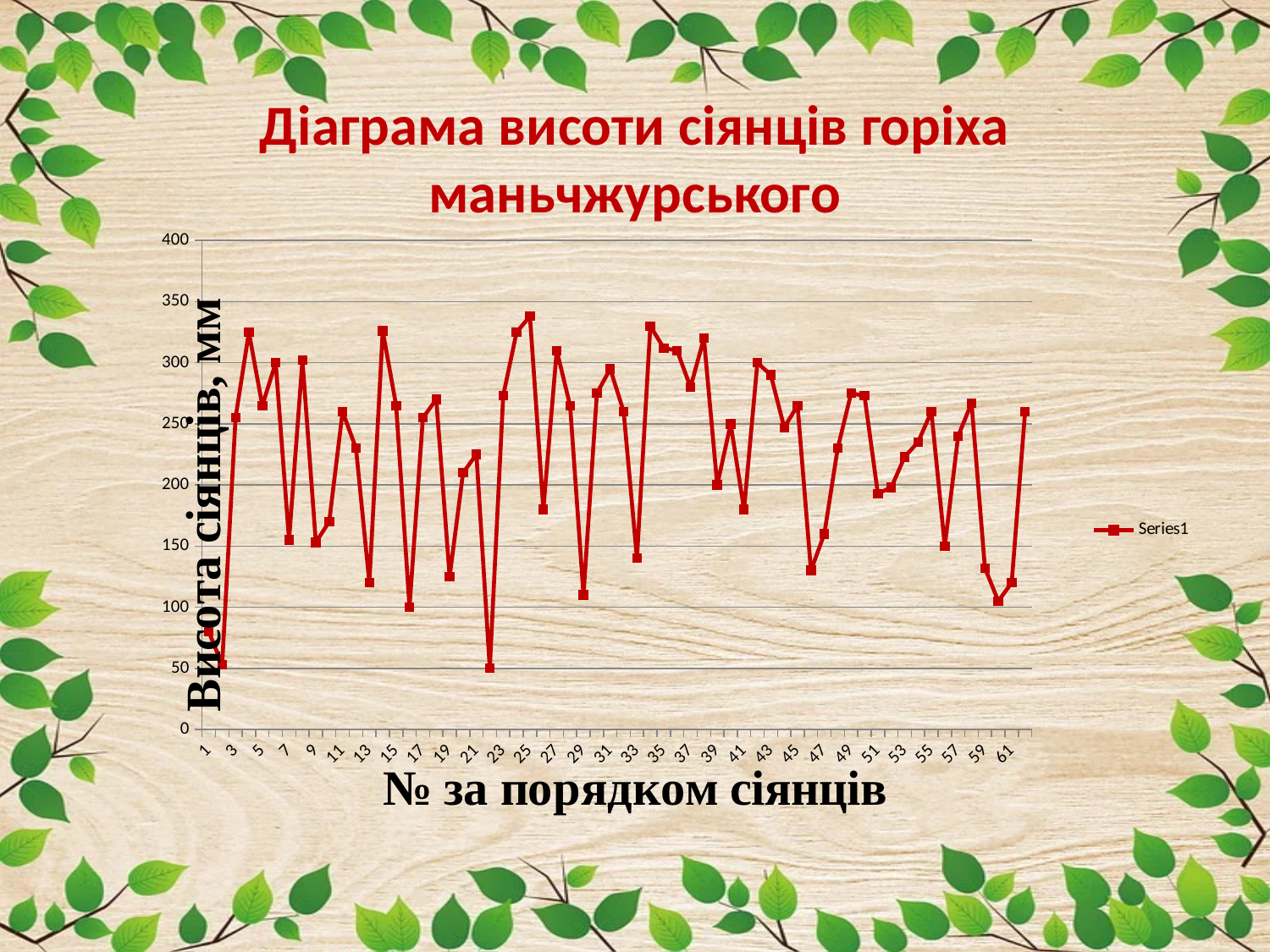
Is the value for seedling 14 greater or less than 300? greater What is the title of the vertical axis? Висота сіянців, мм Is the value for seedling 22 greater or less than 100? less Which has the larger value, seedling 2 or seedling 4? seedling 4 How many series does the legend list? 1 Is the value for seedling 25 greater or less than 300? greater What is the name of the series shown in the legend? Series1 Which has the larger value, seedling 22 or seedling 25? seedling 25 What kind of chart is shown on the slide? line chart